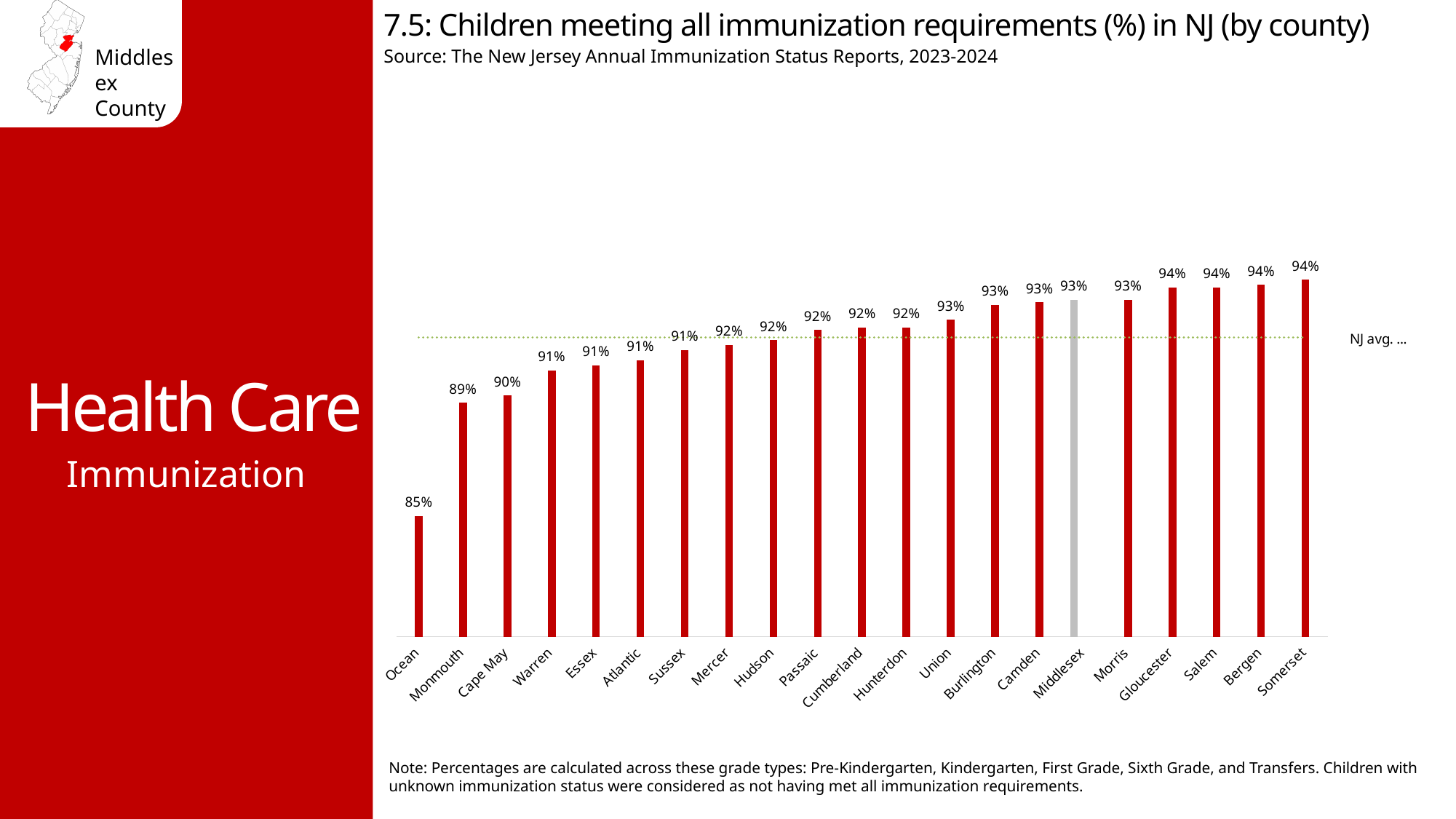
What kind of chart is shown on the slide? Bar chart Which has a higher value, Ocean or Monmouth? Monmouth What percentage of children in Ocean County meet all immunization requirements? 85% What is the difference in percentage points between Middlesex and Monmouth? 4 percentage points What is the value shown for Monmouth? 89% What is the value shown for Middlesex County? 93% Which county has the lowest percentage of children meeting all immunization requirements? Ocean What is the difference in percentage points between Somerset and Ocean? 9 percentage points Do the values generally rise or fall from left to right across the counties? Rise How many counties are shown in the chart? 21 What is the value shown for Cape May? 90% Which has a higher value, Cape May or Somerset? Somerset